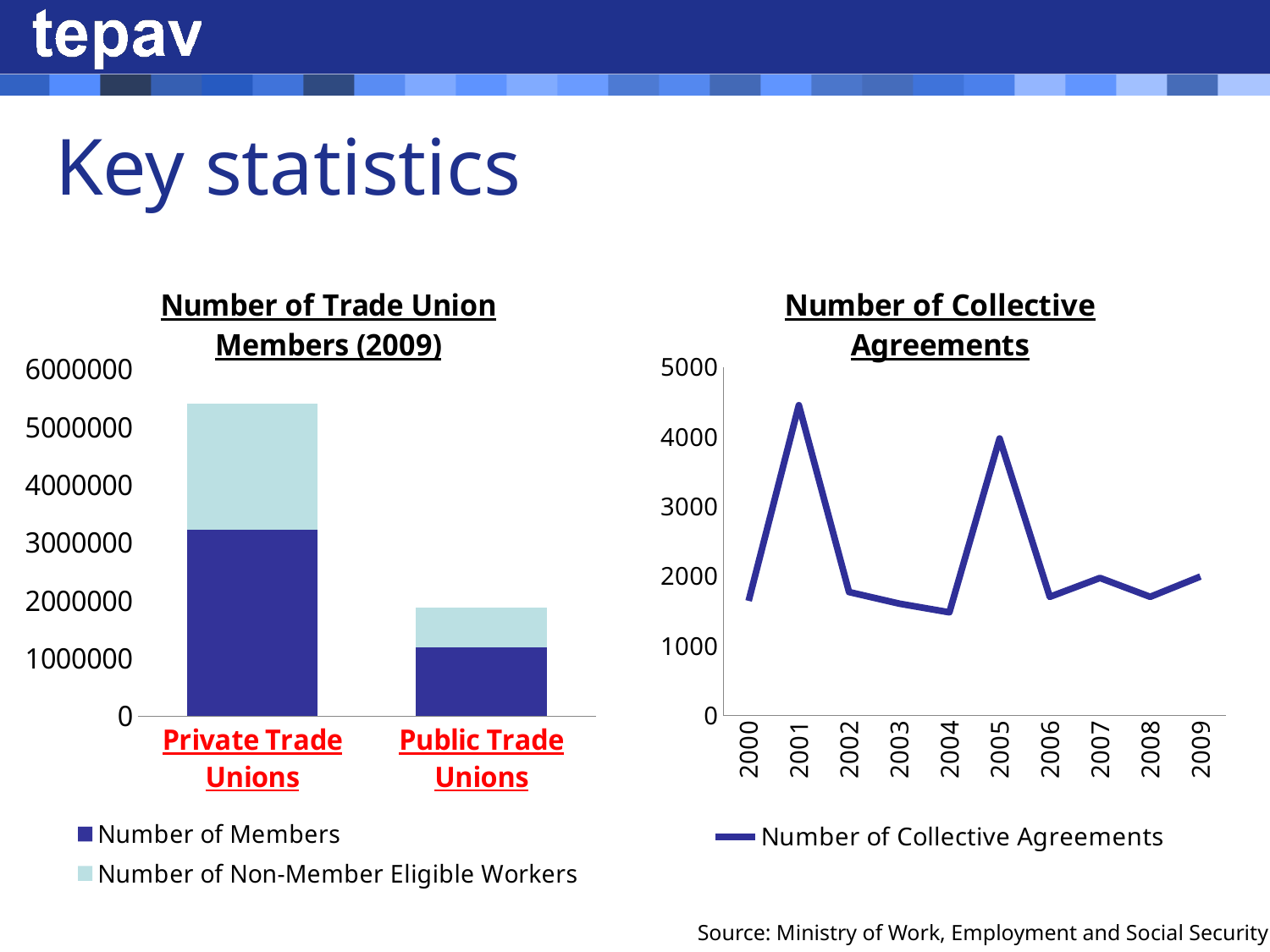
In the 'Number of Trade Union Members (2009)' chart, is the Number of Members for Private Trade Unions greater or less than 3000000? greater In the 'Number of Collective Agreements' chart, do the values rise or fall from 2001 to 2004? fall In the 'Number of Trade Union Members (2009)' chart, is the total bar for Public Trade Unions greater or less than 2000000? less In the 'Number of Collective Agreements' chart, is the value for 2004 greater or less than 2000? less What kind of chart is the 'Number of Collective Agreements' chart? Line chart What kind of chart is the 'Number of Trade Union Members (2009)' chart? Stacked bar chart In the 'Number of Collective Agreements' chart, how many years are shown on the x axis? 10 In the 'Number of Trade Union Members (2009)' chart, which category has the higher total bar? Private Trade Unions In the 'Number of Trade Union Members (2009)' chart, how many series does the legend list? 2 In the 'Number of Collective Agreements' chart, which year has the highest value? 2001